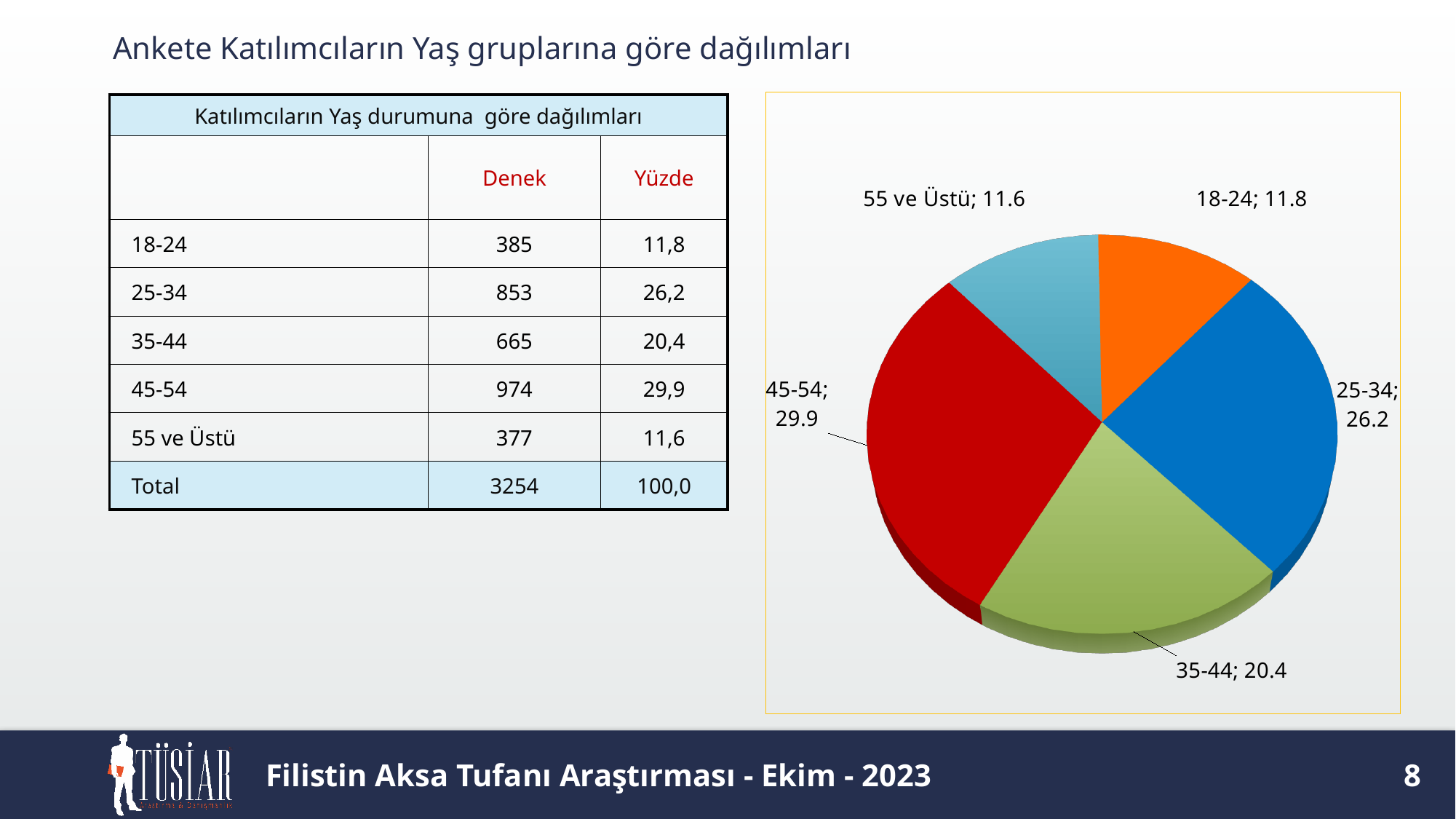
Which age group has the largest slice in the pie chart? 45-54 In the pie chart, what is the difference between the values for 45-54 and 18-24? 18.1 Which age group has the smallest slice in the pie chart? 55 ve Üstü What is the value shown for the 55 ve Üstü slice in the pie chart? 11.6 What share of the pie does the 45-54 slice represent? 29.9 What is the value shown for the 25-34 slice in the pie chart? 26.2 In the pie chart, which slice is larger: 25-34 or 35-44? 25-34 What kind of chart is shown on the slide? pie chart What colour is the 45-54 slice in the pie chart? red In the pie chart, what is the difference between the values for 25-34 and 35-44? 5.8 How many age groups are shown in the pie chart? 5 What is the value shown for the 35-44 slice in the pie chart? 20.4